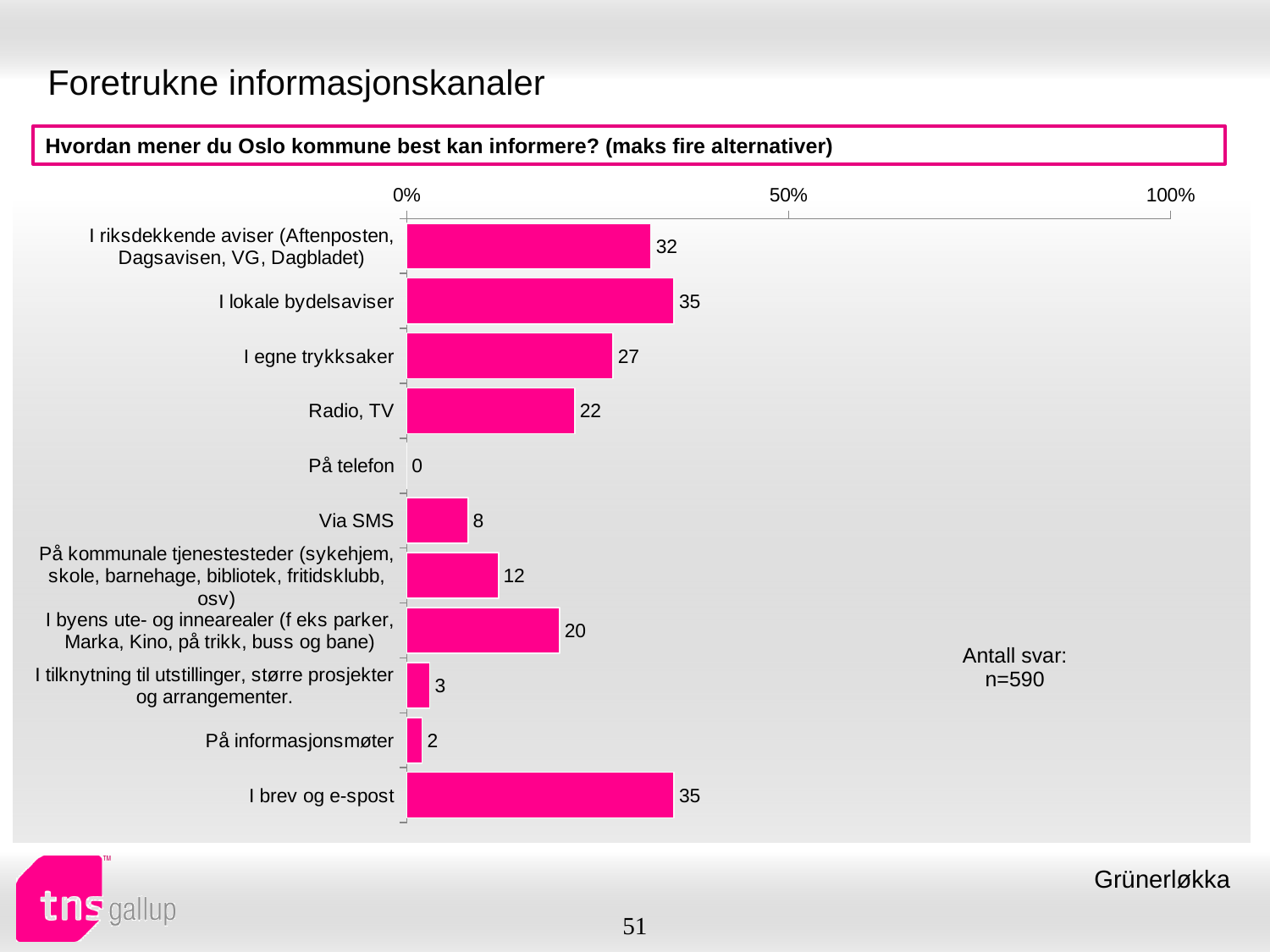
What is the value for "Via SMS"? 8 Which is larger, the value for "Radio, TV" or the value for "I byens ute- og innearealer (f eks parker, Marka, Kino, på trikk, buss og bane)"? Radio, TV How many categories are shown in the chart? 11 What is the difference between the values for "I riksdekkende aviser (Aftenposten, Dagsavisen, VG, Dagbladet)" and "I egne trykksaker"? 5 Which category has the lowest value? På telefon What is the value for "I egne trykksaker"? 27 What is the value for "Radio, TV"? 22 Is the value for "I brev og e-spost" greater or less than 50%? less What is the value for "På informasjonsmøter"? 2 What kind of chart is shown on the slide? bar chart What is the number of responses (n) stated on the slide? n=590 What is the value for "I lokale bydelsaviser"? 35